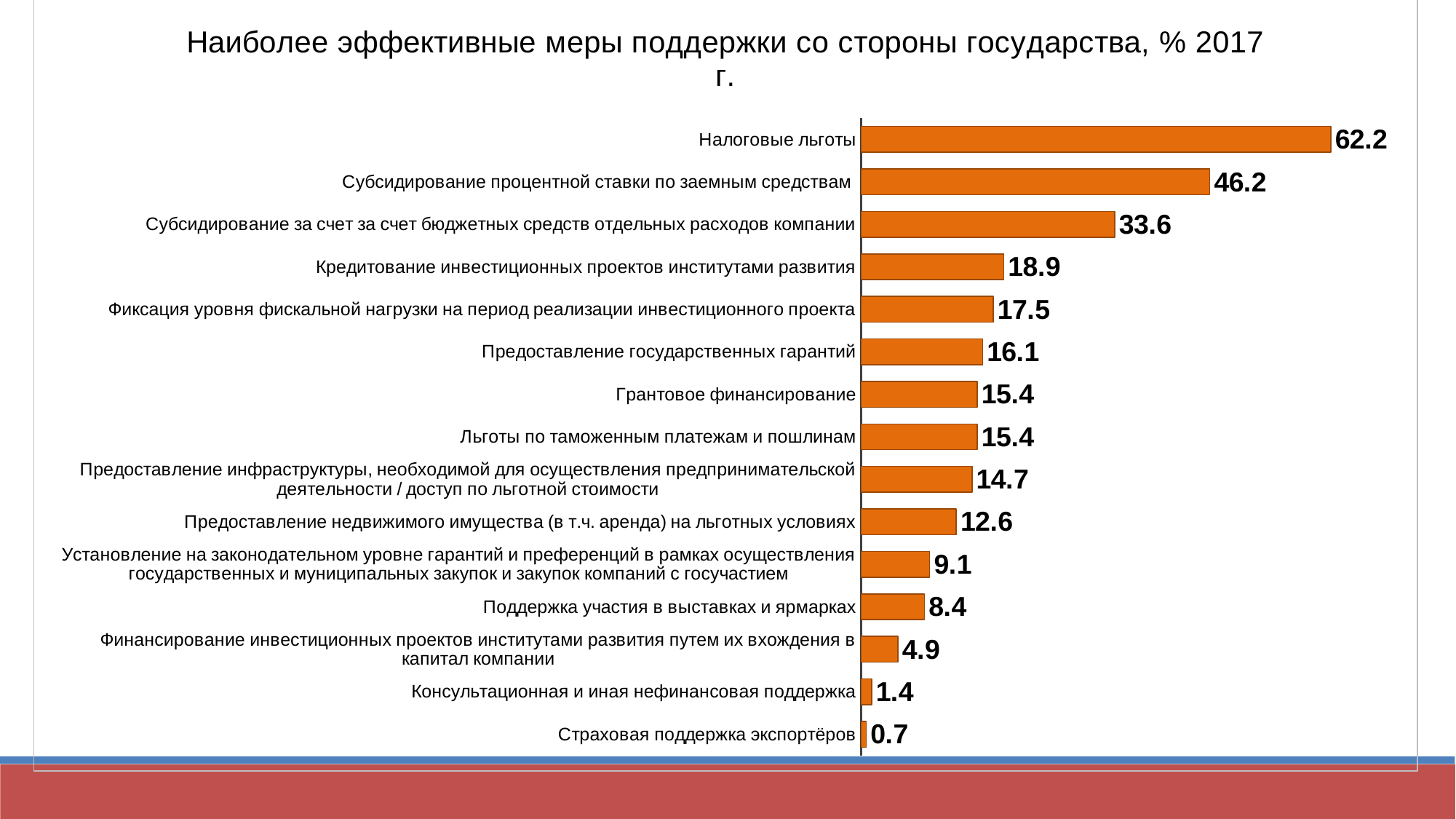
How many categories are shown in the chart? 15 Which category has the highest value? Налоговые льготы Which category has the lowest value? Страховая поддержка экспортёров Which is larger: the value for Предоставление государственных гарантий or the value for Предоставление недвижимого имущества (в т.ч. аренда) на льготных условиях? Предоставление государственных гарантий What is the value for Поддержка участия в выставках и ярмарках? 8.4 What is the difference between the values for Налоговые льготы and Субсидирование процентной ставки по заемным средствам? 16.0 What is the value for Грантовое финансирование? 15.4 What is the title of the chart? Наиболее эффективные меры поддержки со стороны государства, % 2017 г. What kind of chart is shown on the slide? Bar chart What is the value for Налоговые льготы? 62.2 What is the value for Страховая поддержка экспортёров? 0.7 What is the difference between the values for Кредитование инвестиционных проектов институтами развития and Фиксация уровня фискальной нагрузки на период реализации инвестиционного проекта? 1.4